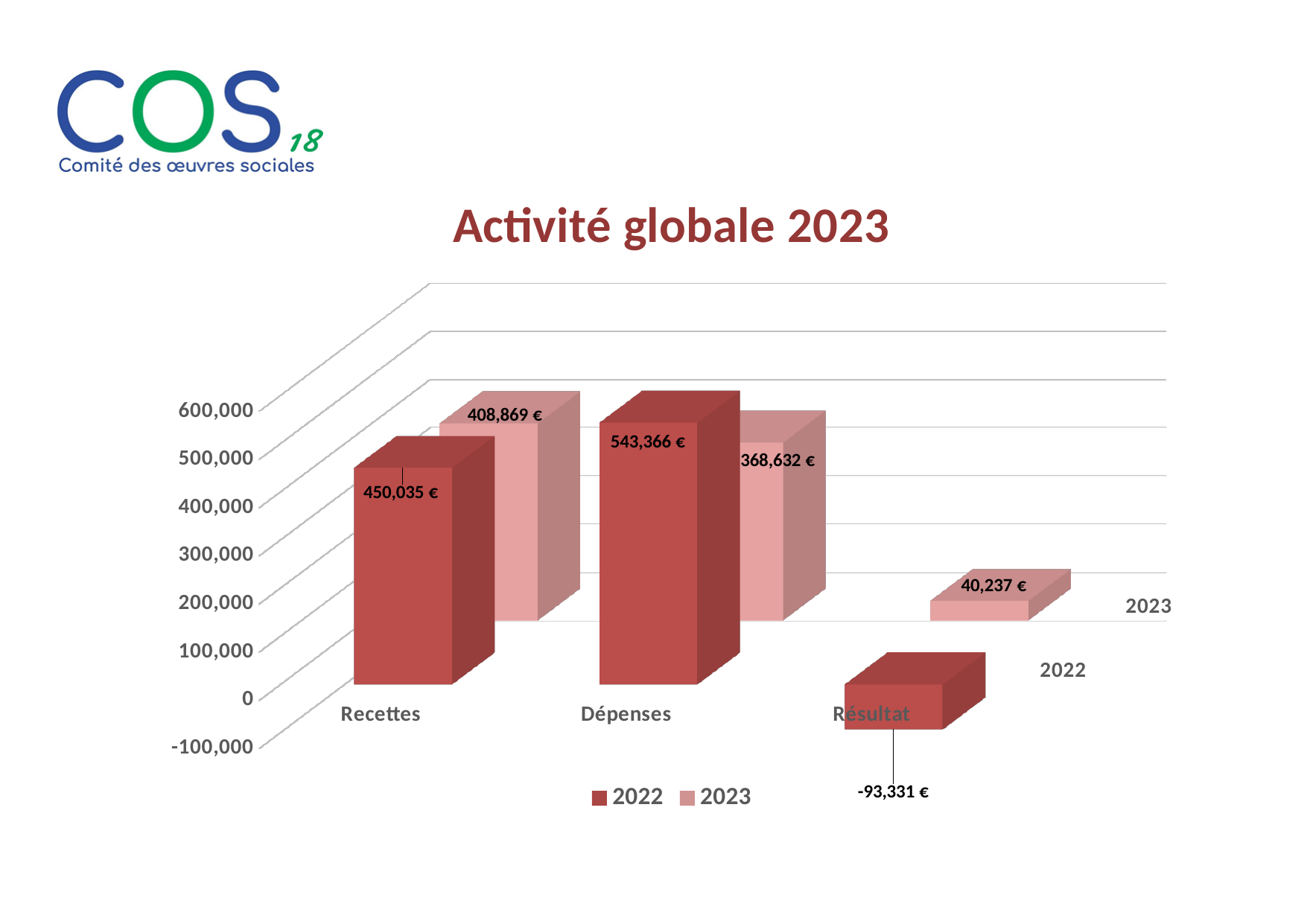
How many series does the legend list? 2 What type of chart is shown on the slide? bar chart Which category has the lowest value in the 2023 series? Résultat What is the value of Résultat for 2023? 40,237 € Which category has the highest value in the 2022 series? Dépenses Which is larger: Recettes in 2023 or Dépenses in 2023? Recettes in 2023 What is the value of Résultat for 2022? -93,331 € What is the value of Recettes for 2022? 450,035 € What is the difference between Dépenses in 2022 and Dépenses in 2023? 174,734 € How many categories are shown on the x axis? 3 What is the value of Dépenses for 2023? 368,632 € What is the title of the chart? Activité globale 2023